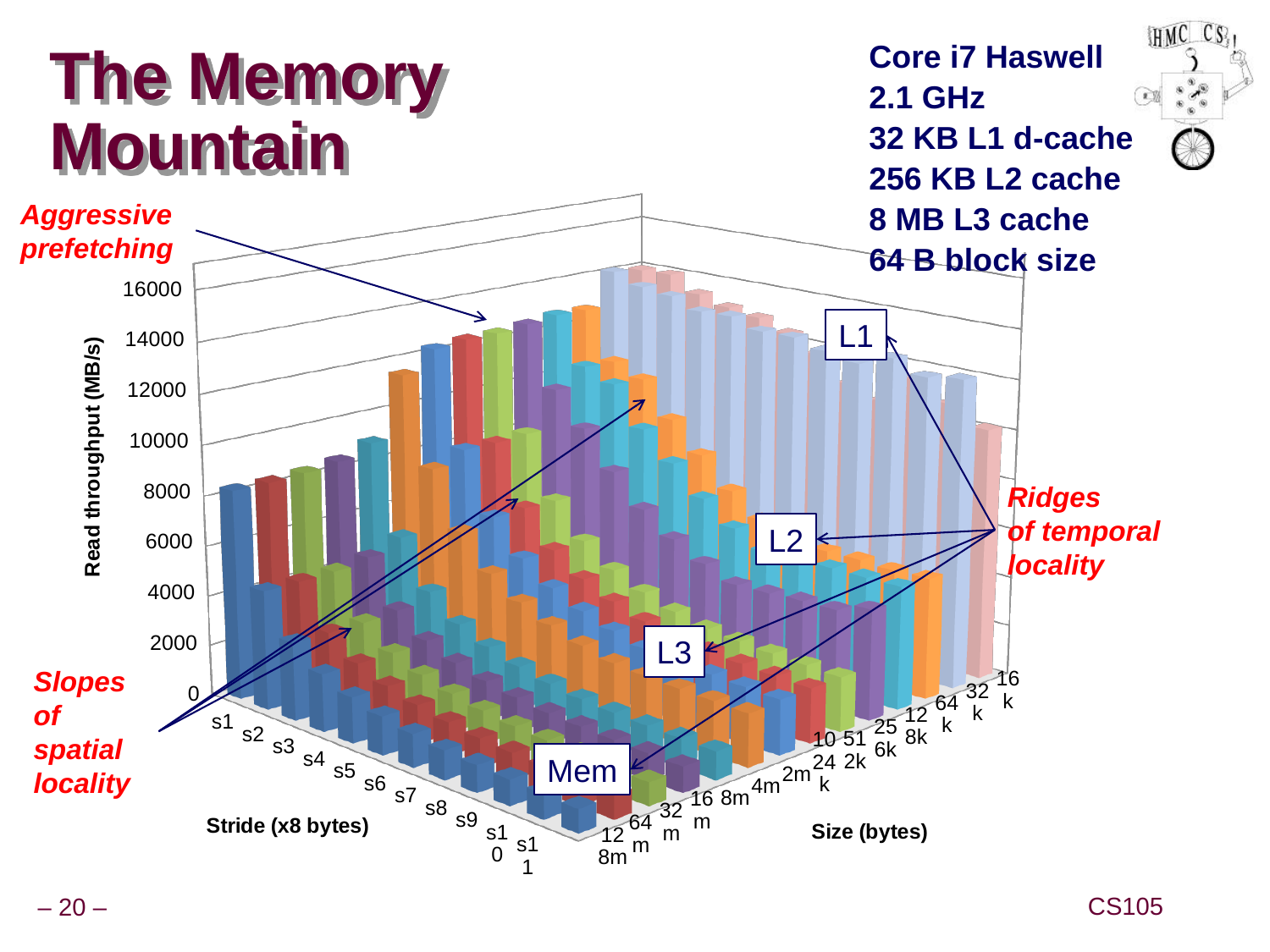
Which stride has the lowest read throughput for the largest sizes? s11 Does read throughput generally rise or fall as the working-set size decreases from 128m toward 16k? rise What is the title of the slide containing the chart? The Memory Mountain Which of the labelled ridges, L1 or Mem, corresponds to higher read throughput? L1 What is the label of the axis that runs from s1 to s11? Stride (x8 bytes) What is the label of the vertical axis of the chart? Read throughput (MB/s) Does read throughput generally rise or fall as the stride increases from s1 to s11? fall How many stride categories (s1 through s11) are shown on the stride axis? 11 What is the highest tick value shown on the read throughput axis? 16000 What kind of chart is shown on the slide? 3D bar chart What is the interval between consecutive tick marks on the read throughput axis? 2000